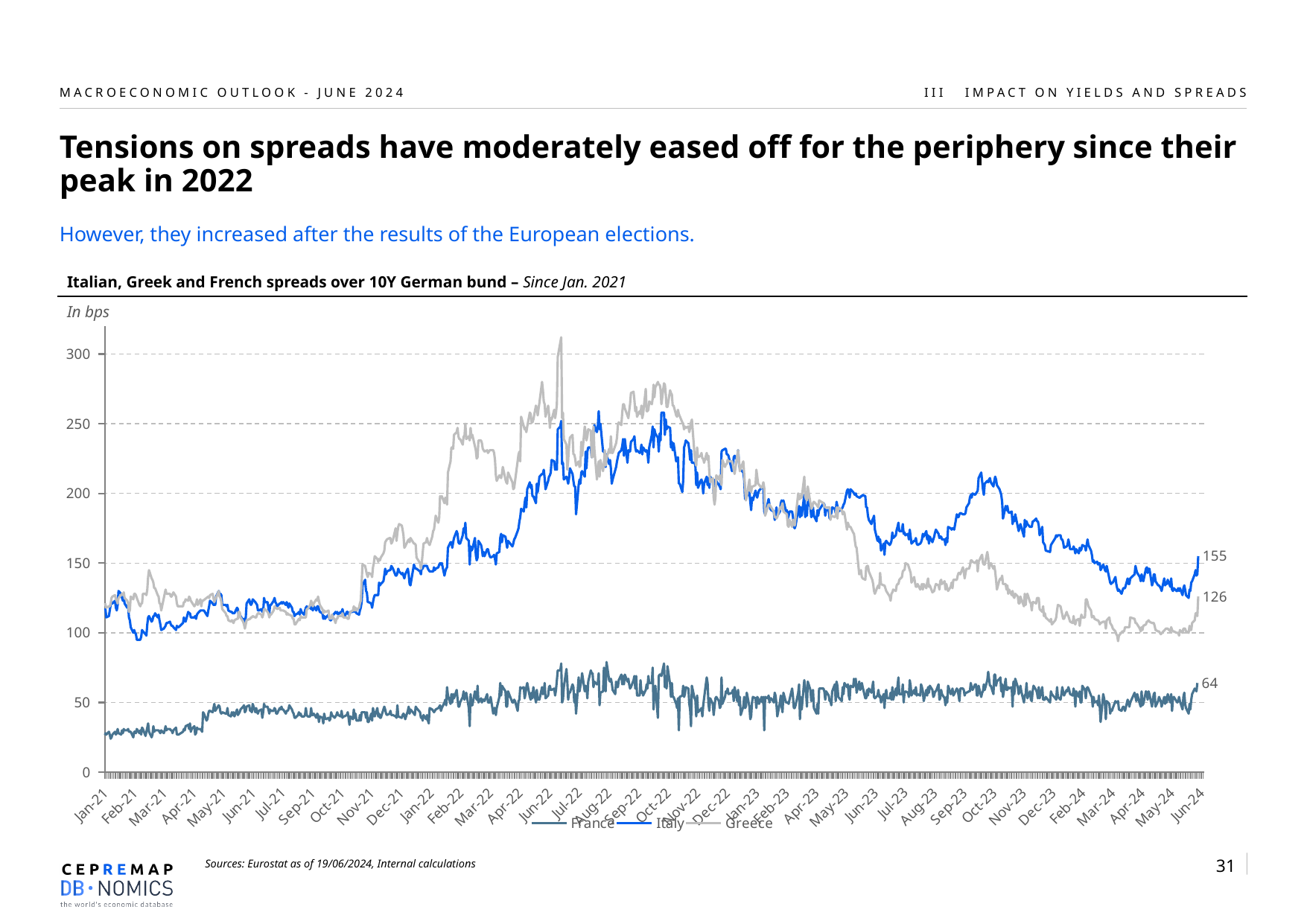
Which series has the lowest value at the end of the chart (Jun-24)? France How many series does the legend list? 3 What is the latest value shown for Italy at the end of the series (Jun-24)? 155 At the end of the series, is the value for Greece larger or smaller than the value for France? larger Is the value for France in Jan-21 greater or less than 50? less What is the latest value shown for Greece at the end of the series (Jun-24)? 126 What unit is the chart's y axis expressed in? bps What is the difference between the end-of-series values for Italy and France? 91 Which series has the highest value at the end of the chart (Jun-24)? Italy What type of chart is shown on the slide? line chart What is the latest value shown for France at the end of the series (Jun-24)? 64 What is the difference between the end-of-series values for Italy and Greece? 29